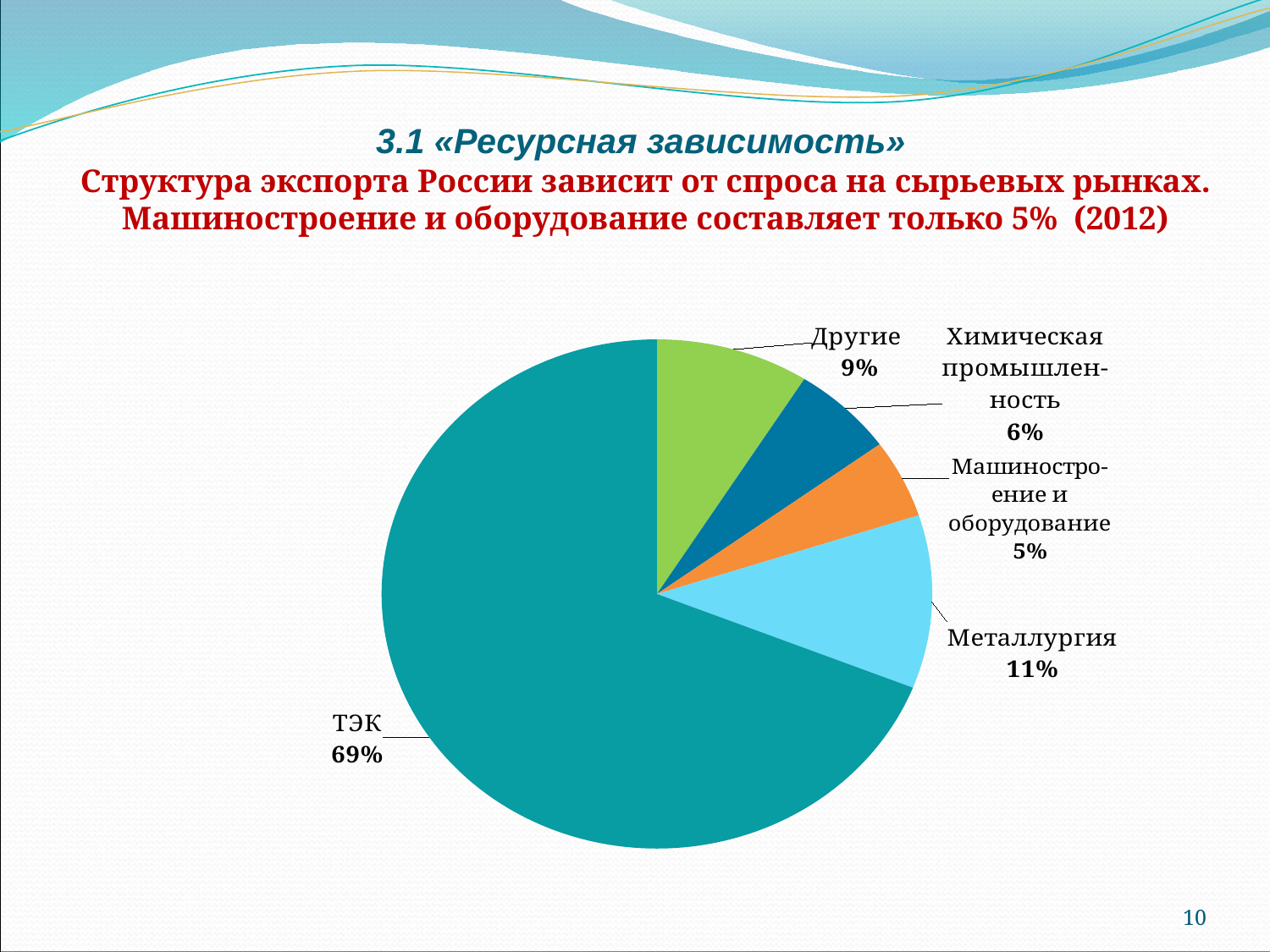
What colour is the ТЭК slice? Teal Which category has the smallest share of the pie? Машиностроение и оборудование Which category has the largest share of the pie? ТЭК What is the value shown for Металлургия? 11% What is the value shown for Машиностроение и оборудование? 5% How many categories are shown in the pie chart? 5 What share of the pie does ТЭК account for? 69% What is the difference between the shares of ТЭК and Металлургия? 58% What is the value shown for Химическая промышленность? 6% Which is larger, the share of Другие or the share of Химическая промышленность? Другие What kind of chart is shown on the slide? Pie chart What is the value shown for Другие? 9%